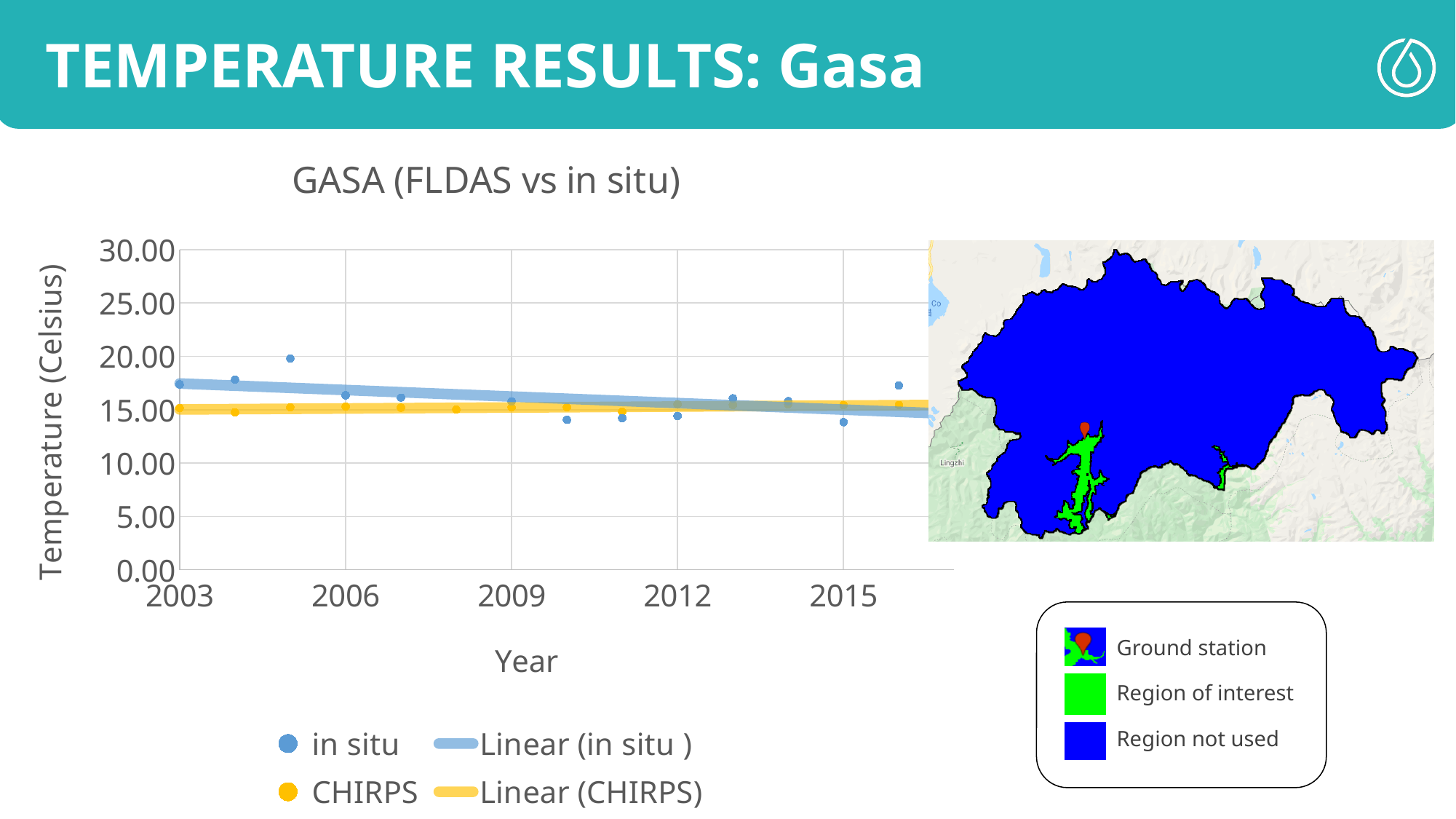
How many series does the chart legend list? 4 Is the in situ value for 2003 greater or less than 15.00? greater Is the in situ value for 2005 greater or less than 15.00? greater Does the Linear (in situ) trend line rise or fall from 2003 to 2016? fall Is the CHIRPS value for 2009 greater or less than 10.00? greater What kind of chart is shown on the slide? scatter chart What is the title of the chart? GASA (FLDAS vs in situ) Which is larger in 2005, the in situ value or the CHIRPS value? in situ In which year is the in situ temperature highest? 2005 Which is larger in 2003, the in situ value or the CHIRPS value? in situ What is the label of the vertical axis of the chart? Temperature (Celsius)